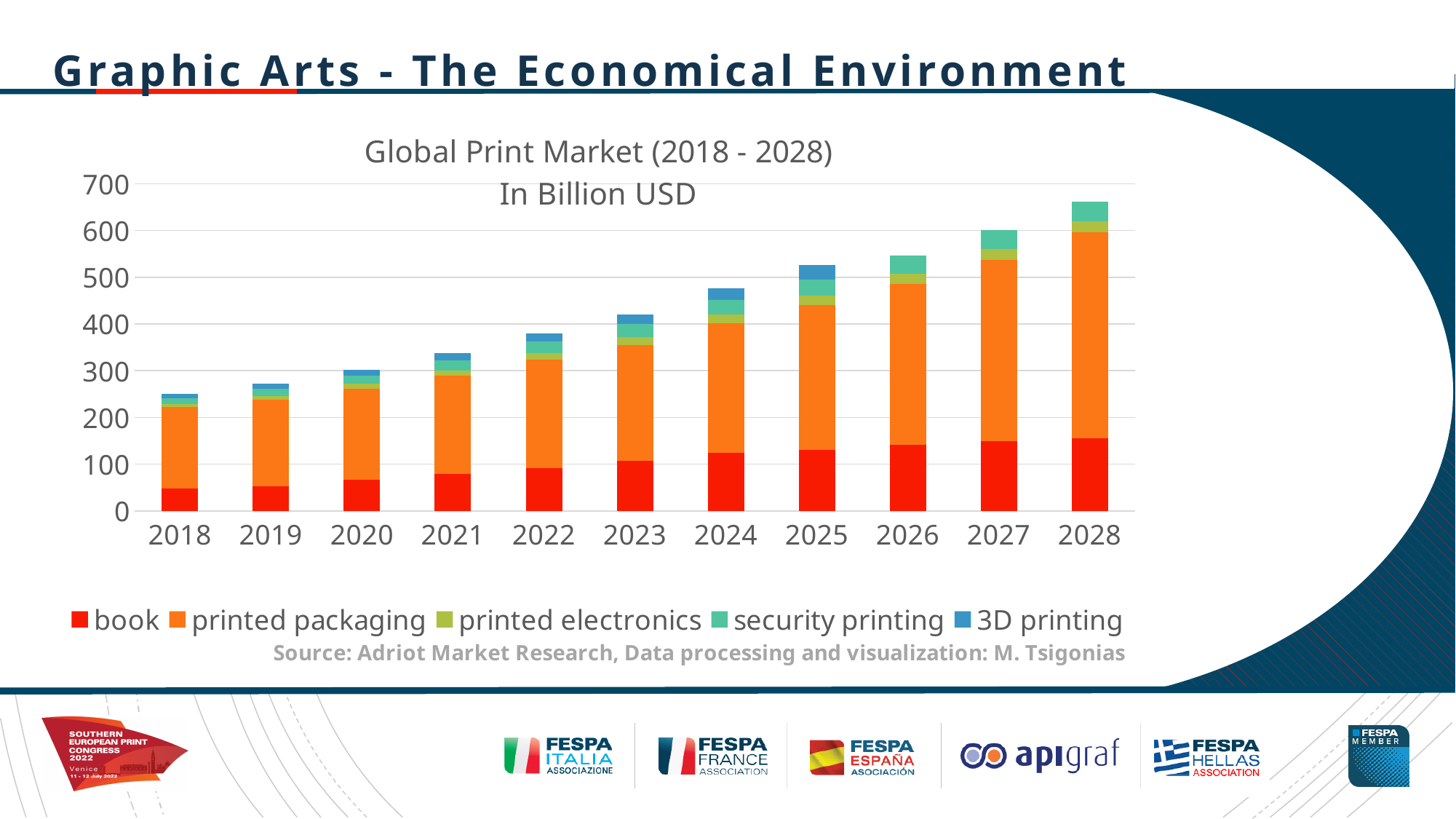
Is the total value for 2028 greater or less than 600? greater What is the title of the chart? Global Print Market (2018 - 2028) In Billion USD Is the book value for 2028 greater or less than 100? greater Is the total value for 2024 greater or less than 500? less How many years are shown on the x axis? 11 Which year has the lowest total bar? 2018 Which year has the highest total bar? 2028 Which series is shown in red in the legend? book What kind of chart is shown on the slide? stacked bar chart Do the total bar values rise or fall from 2018 to 2028? rise How many series does the legend list? 5